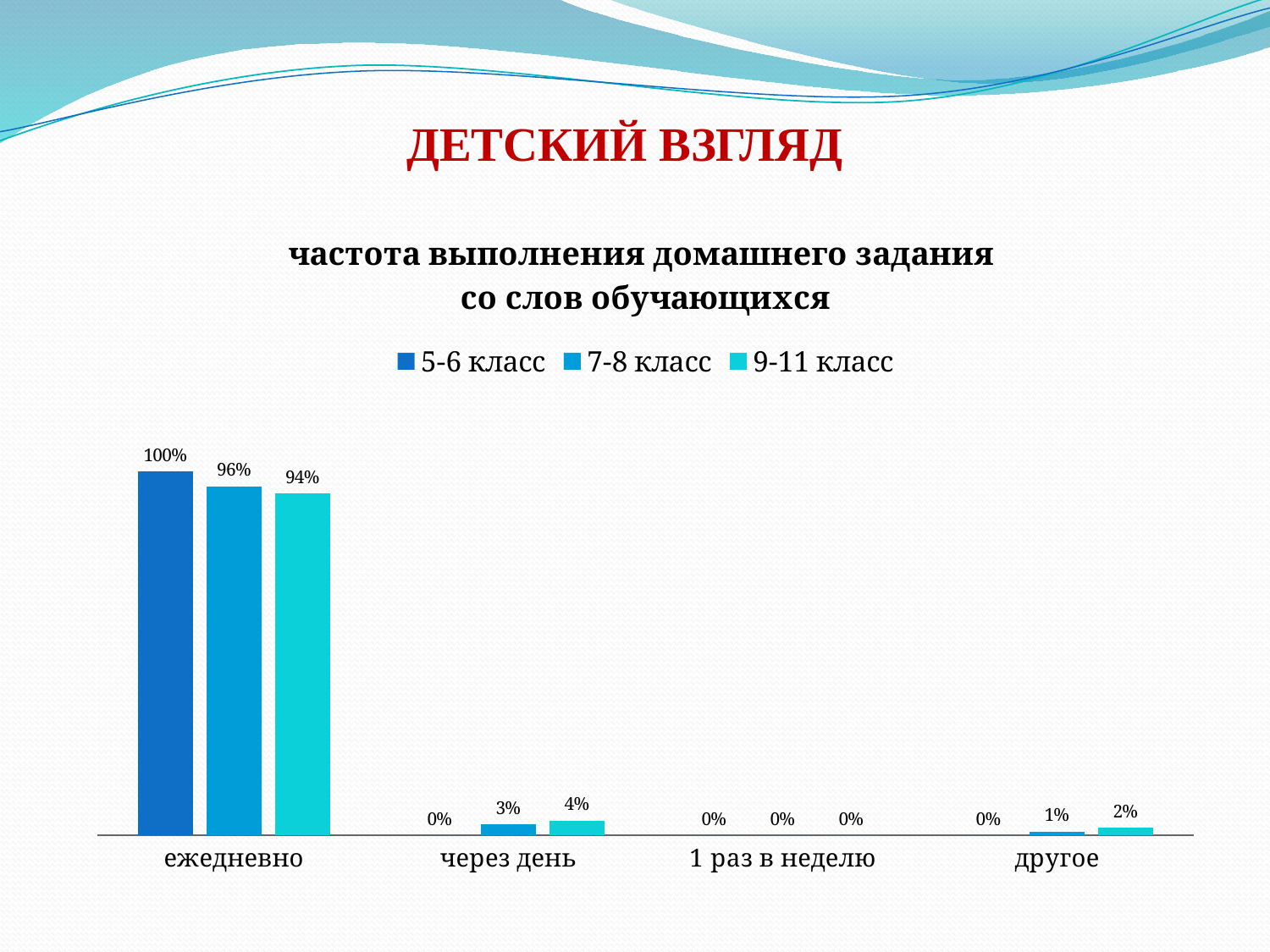
What is the title of the chart? частота выполнения домашнего задания со слов обучающихся What is the value for 7-8 класс in the ежедневно category? 96% What is the value for 9-11 класс in the через день category? 4% How many categories are shown on the x axis? 4 What is the value for 7-8 класс in the другое category? 1% What is the difference between the 5-6 класс and 9-11 класс values in the ежедневно category? 6% How many series does the legend list? 3 Which is larger in the через день category: the value for 7-8 класс or for 9-11 класс? 9-11 класс What is the value for 5-6 класс in the ежедневно category? 100% Which series has the highest value in the ежедневно category? 5-6 класс What kind of chart is shown on the slide? bar chart Which category has the lowest values for all three series? 1 раз в неделю